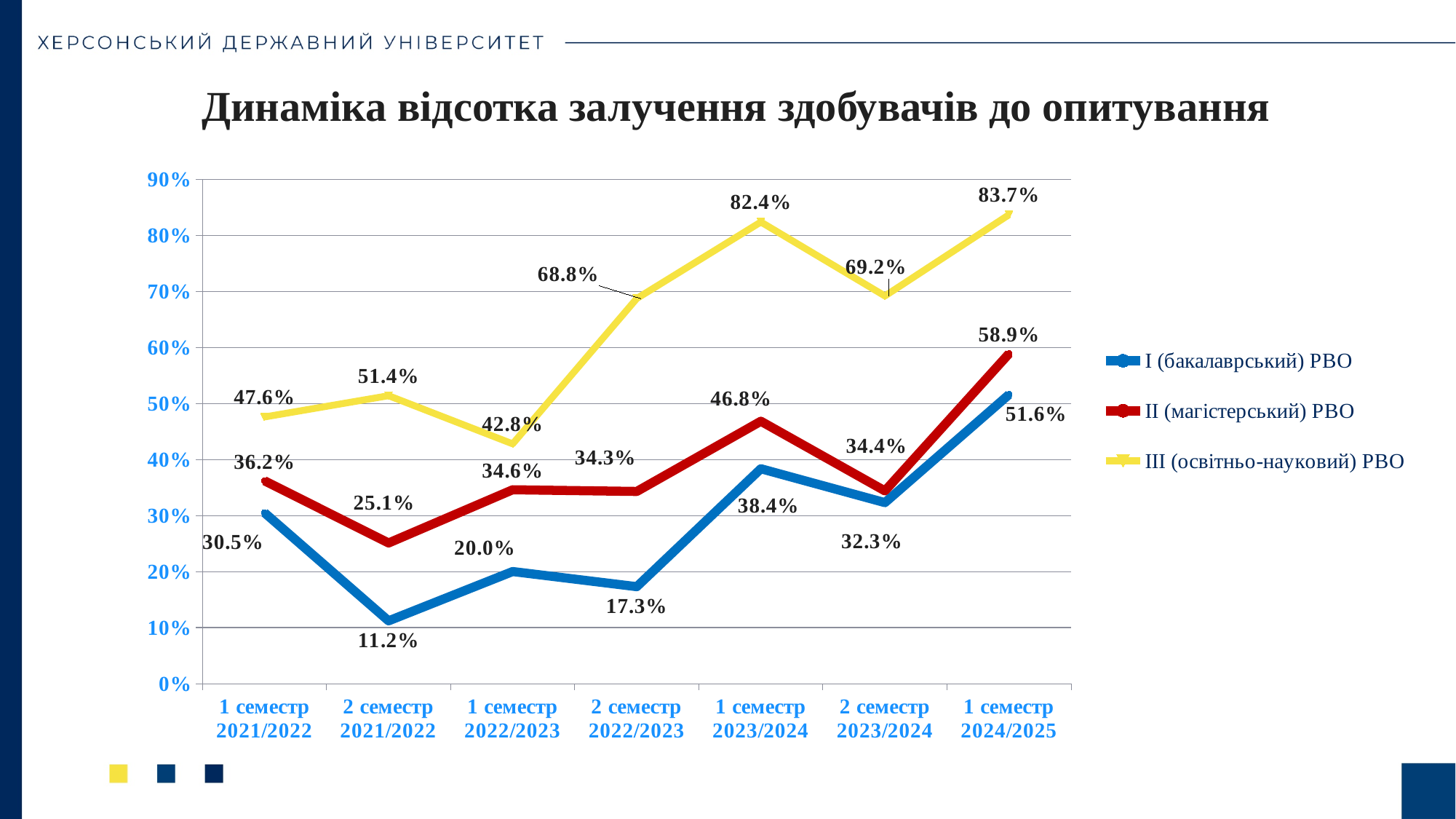
What is the value for II (магістерський) РВО in 1 семестр 2024/2025? 58.9% What is the title of the chart? Динаміка відсотка залучення здобувачів до опитування How many semesters are plotted along the x axis? 7 What is the value for III (освітньо-науковий) РВО in 1 семестр 2023/2024? 82.4% What is the difference between III (освітньо-науковий) РВО and I (бакалаврський) РВО in 1 семестр 2024/2025? 32.1% What is the value for I (бакалаврський) РВО in 2 семестр 2021/2022? 11.2% Does the value for I (бакалаврський) РВО rise or fall from 2 семестр 2023/2024 to 1 семестр 2024/2025? rise In which semester does I (бакалаврський) РВО have its lowest value? 2 семестр 2021/2022 How many series does the legend list? 3 Which is larger in 2 семестр 2022/2023: II (магістерський) РВО or I (бакалаврський) РВО? II (магістерський) РВО What type of chart is shown on the slide? line chart In which semester does III (освітньо-науковий) РВО reach its highest value? 1 семестр 2024/2025